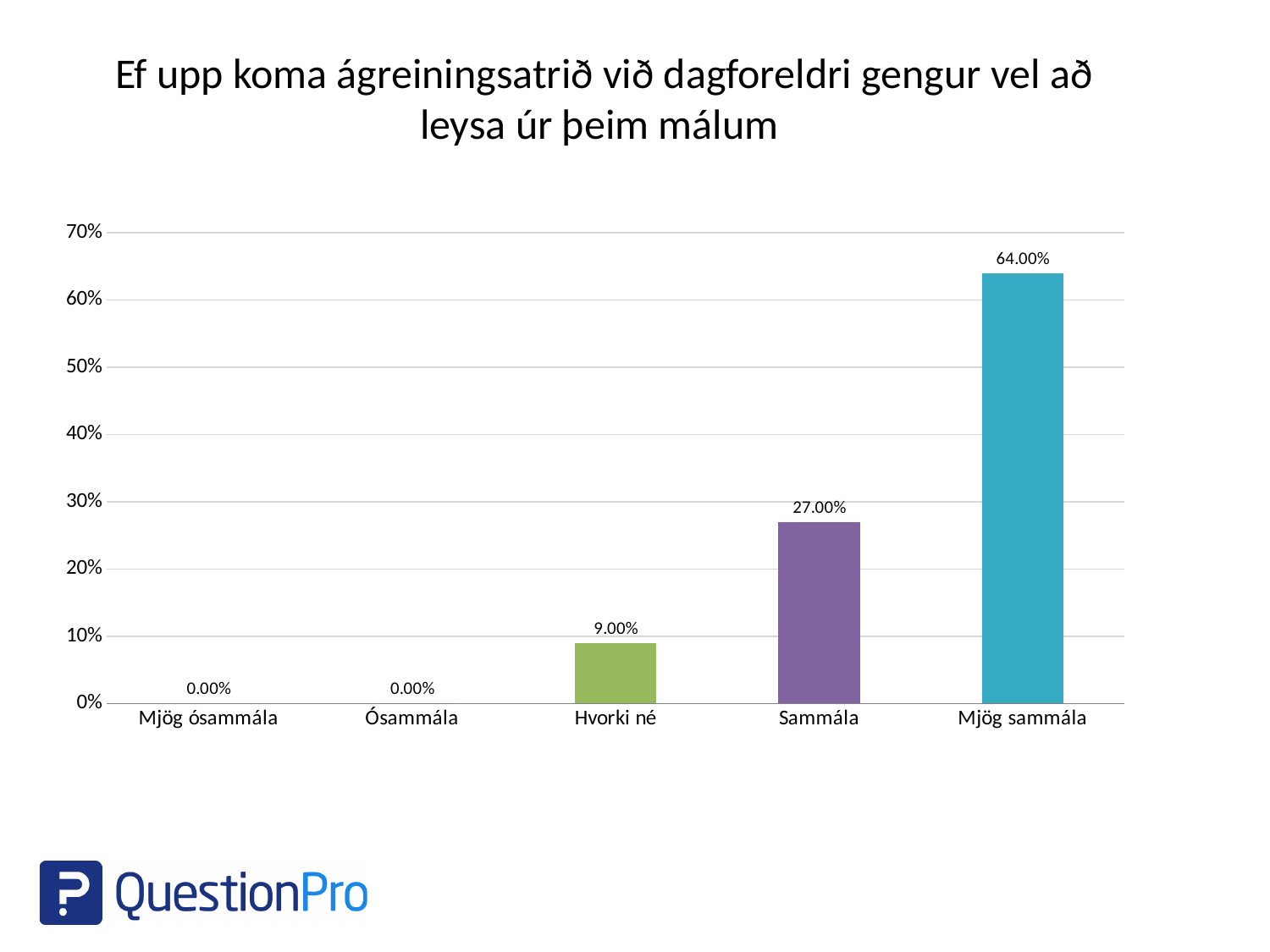
How many categories are shown on the x axis? 5 What is the value for Ósammála? 0.00% Is the value for Mjög sammála greater or less than 60%? greater What is the title of the chart? Ef upp koma ágreiningsatrið við dagforeldri gengur vel að leysa úr þeim málum Do the values rise or fall from left to right along the x axis? Rise What is the value for Sammála? 27.00% What is the difference between the values for Mjög sammála and Sammála? 37.00% What kind of chart is shown on the slide? Bar chart Which category has the highest value? Mjög sammála Which is larger, the value for Sammála or the value for Hvorki né? Sammála What is the value for Mjög sammála? 64.00% What is the value for Hvorki né? 9.00%